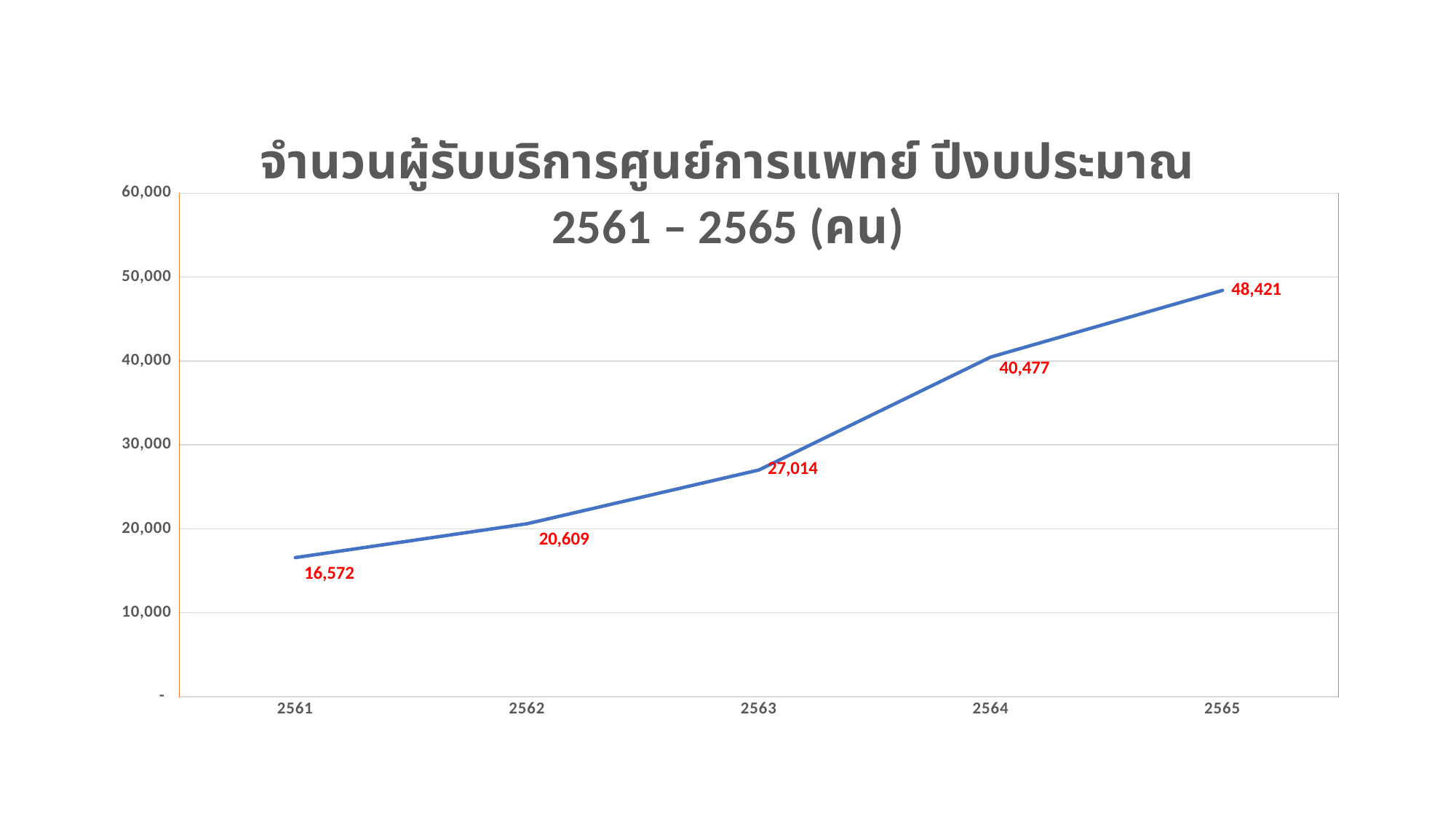
Do the values rise or fall from 2561 to 2565? rise What is the value for 2565? 48,421 What is the value for 2561? 16,572 What kind of chart is shown on the slide? line chart What is the difference between the values for 2564 and 2563? 13,463 What is the value for 2563? 27,014 Which is larger, the value for 2562 or the value for 2563? 2563 Which year has the highest value? 2565 How many years are plotted on the x axis? 5 Which year has the lowest value? 2561 What is the difference between the values for 2565 and 2561? 31,849 Is the value for 2564 greater or less than 40,000? greater